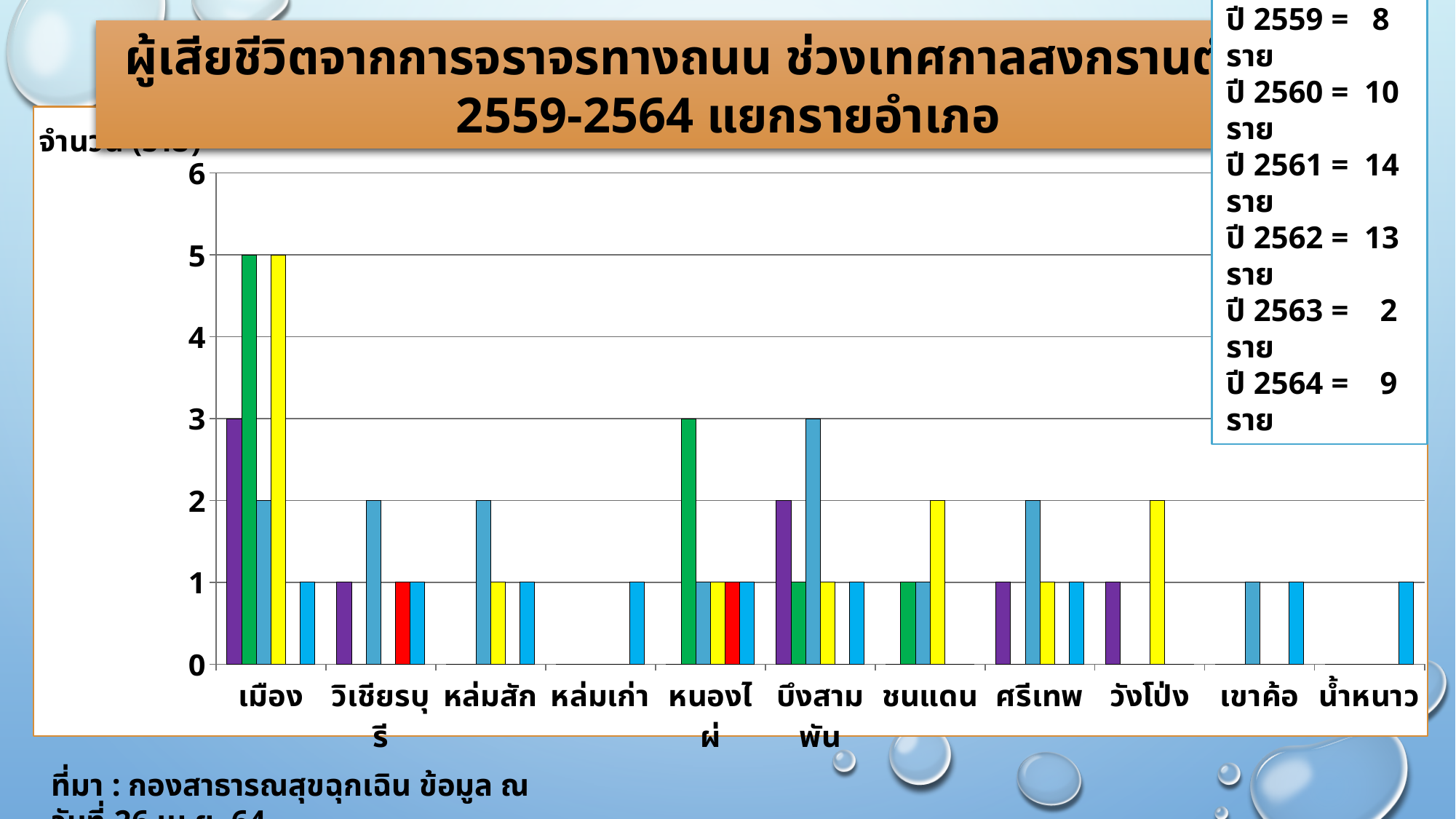
What is the value of the tallest bar for the district หนองไผ่? 3 According to the text box on the slide, how many deaths (ราย) are listed for ปี 2561? 14 ราย How many districts (categories) are shown on the x axis of the chart? 11 What is the highest tick value shown on the y axis of the chart? 6 How many bars are plotted for the district เมือง? 5 Is the tallest bar for เมือง greater or less than 4? greater Which district has a taller maximum bar, เมือง or วิเชียรบุรี? เมือง What is the highest value reached by any bar in the chart? 5 What kind of chart is shown on the slide? bar chart How many bars are plotted for the district น้ำหนาว? 1 Which district has the tallest bar in the chart? เมือง What is the value of the tallest bar for the district บึงสามพัน? 3